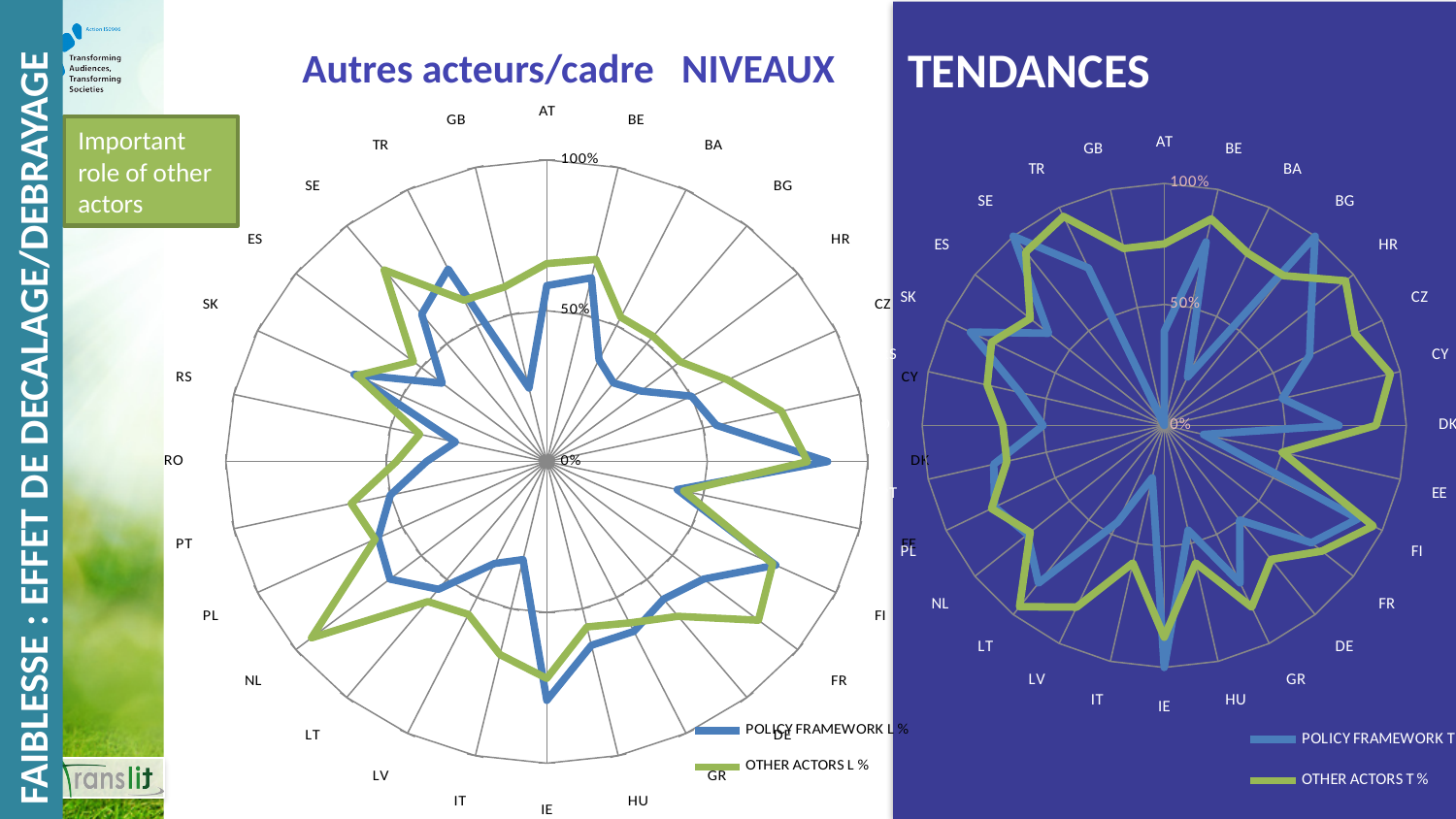
In the left chart 'Autres acteurs/cadre NIVEAUX', is the POLICY FRAMEWORK L % value for DK greater or less than 50%? greater In the left chart 'Autres acteurs/cadre NIVEAUX', what are the two series named in the legend? POLICY FRAMEWORK L % and OTHER ACTORS L % In the right chart 'TENDANCES', is the POLICY FRAMEWORK T % value for IE greater or less than 50%? greater What kind of chart is the left chart titled 'Autres acteurs/cadre NIVEAUX'? Radar chart What kind of chart is the right chart titled 'TENDANCES'? Radar chart How many series does the legend of the left chart 'Autres acteurs/cadre NIVEAUX' list? 2 How many series does the legend of the right chart 'TENDANCES' list? 2 In the right chart 'TENDANCES', which series is drawn in green according to the legend? OTHER ACTORS T % In the right chart 'TENDANCES', is the OTHER ACTORS T % value for CY greater or less than 50%? greater